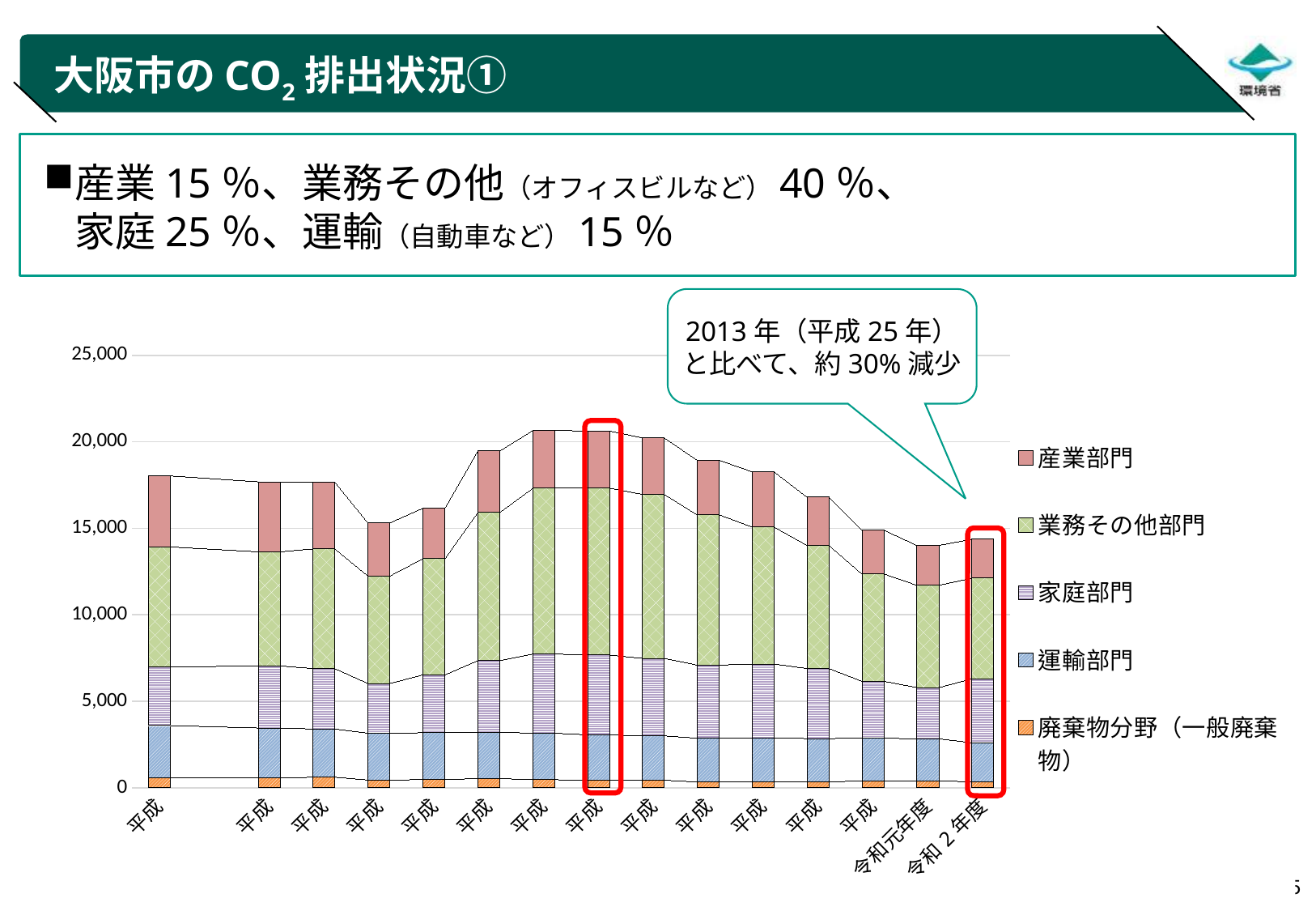
Which series is listed last in the chart's legend? 廃棄物分野（一般廃棄物） How many series does the chart's legend list? 5 How many bars (fiscal years) are plotted in the chart? 15 What kind of chart is shown on the slide? Stacked bar chart Is the total value of the bar for 令和元年度 greater or less than 15,000? less Is the total value of the bar for 令和2年度 greater or less than 10,000? greater Which series is listed first (at the top) in the chart's legend? 産業部門 Do the total bar values rise or fall from the red-boxed 平成25年 bar to the 令和2年度 bar? fall Is the total value of the bar for 令和2年度 greater or less than 15,000? less